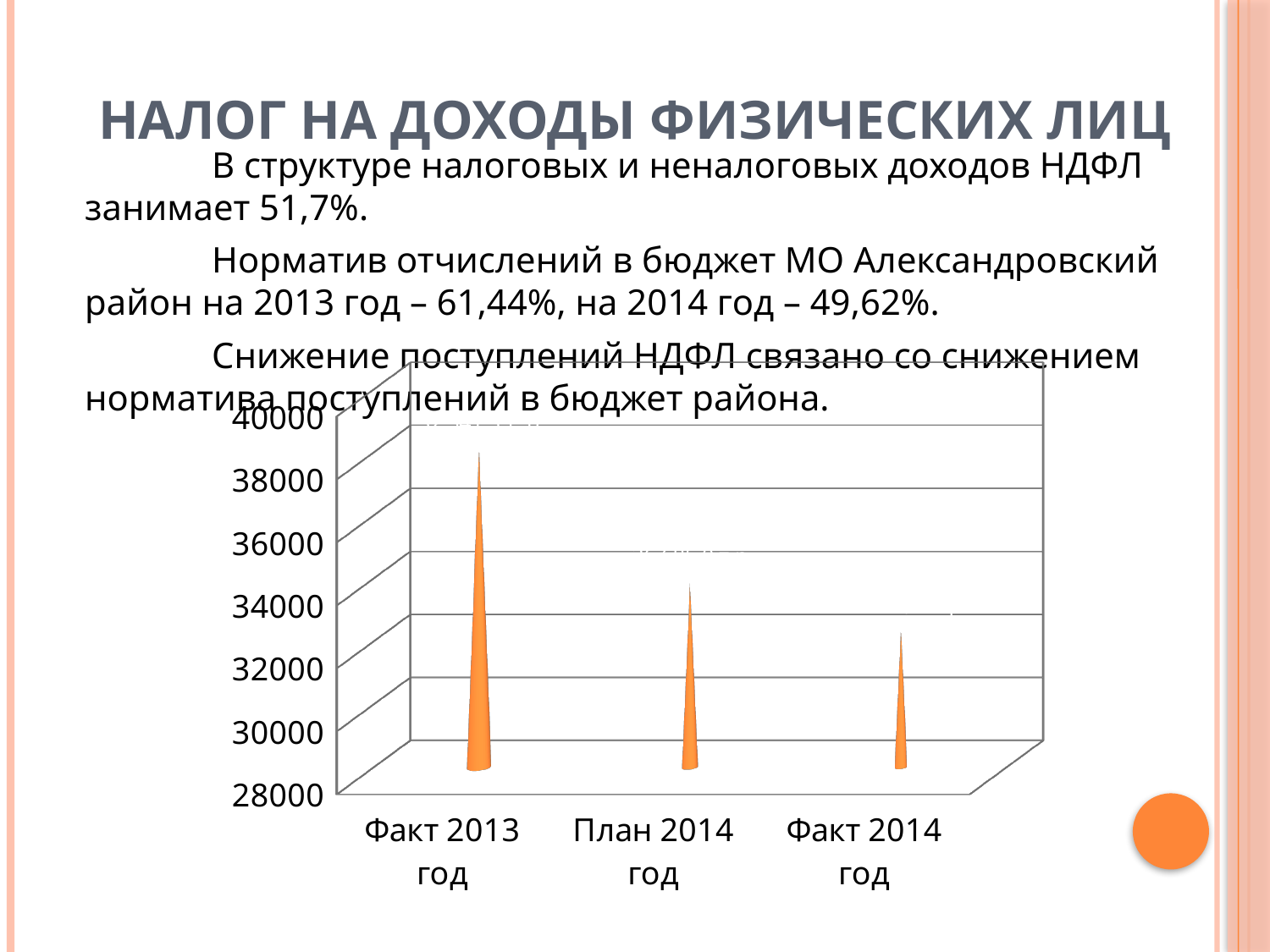
Which category has the highest value in the chart? Факт 2013 год What kind of chart is shown on the slide? bar chart Do the values rise or fall from left to right along the x axis? fall What is the lowest value shown on the vertical axis of the chart? 28000 Is the value for Факт 2014 год greater or less than 34000? less What colour are the bars in the chart? orange Is the value for План 2014 год greater or less than 36000? less Is the value for Факт 2013 год greater or less than 36000? greater Which is larger, the value for Факт 2013 год or the value for План 2014 год? Факт 2013 год Which category has the lowest value in the chart? Факт 2014 год Which is larger, the value for План 2014 год or the value for Факт 2014 год? План 2014 год How many categories are shown on the x axis of the chart? 3